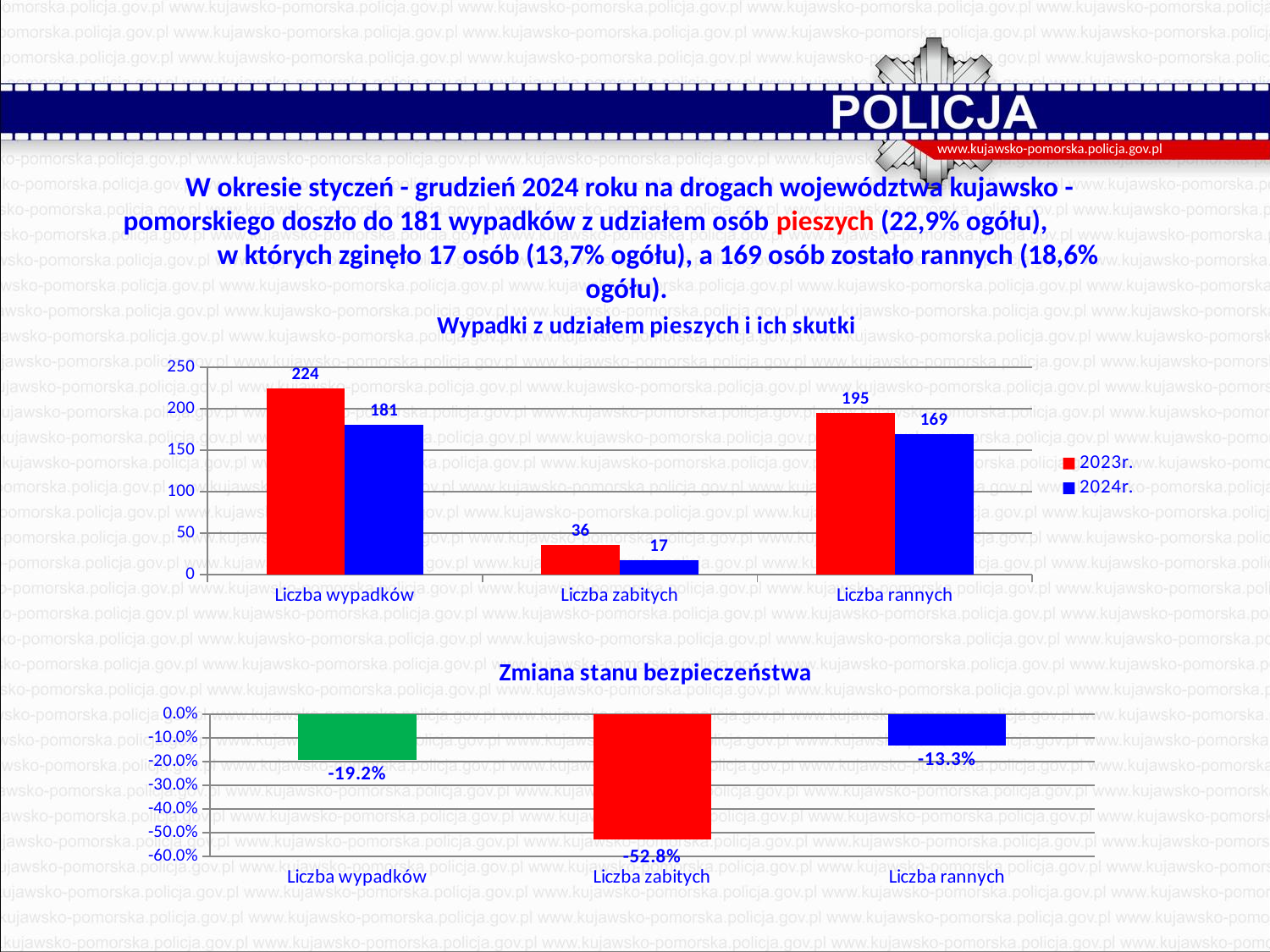
What kind of chart is 'Zmiana stanu bezpieczeństwa'? bar chart In the chart 'Wypadki z udziałem pieszych i ich skutki', what is the difference between the 2023r. and 2024r. values for Liczba wypadków? 43 How many categories are shown in the chart 'Zmiana stanu bezpieczeństwa'? 3 In the chart 'Wypadki z udziałem pieszych i ich skutki', which category has the lowest value for 2024r.? Liczba zabitych In the chart 'Wypadki z udziałem pieszych i ich skutki', what is the value for Liczba rannych in 2023r.? 195 In the chart 'Zmiana stanu bezpieczeństwa', what is the value for Liczba zabitych? -52.8% In the chart 'Wypadki z udziałem pieszych i ich skutki', what is the value for Liczba zabitych in 2024r.? 17 How many series does the legend of the chart 'Wypadki z udziałem pieszych i ich skutki' list? 2 In the chart 'Zmiana stanu bezpieczeństwa', what is the value for Liczba rannych? -13.3% In the chart 'Wypadki z udziałem pieszych i ich skutki', which is larger: Liczba rannych in 2023r. or Liczba wypadków in 2024r.? Liczba rannych in 2023r. In the chart 'Zmiana stanu bezpieczeństwa', which category shows the largest decrease? Liczba zabitych In the chart 'Wypadki z udziałem pieszych i ich skutki', what is the value for Liczba wypadków in 2023r.? 224